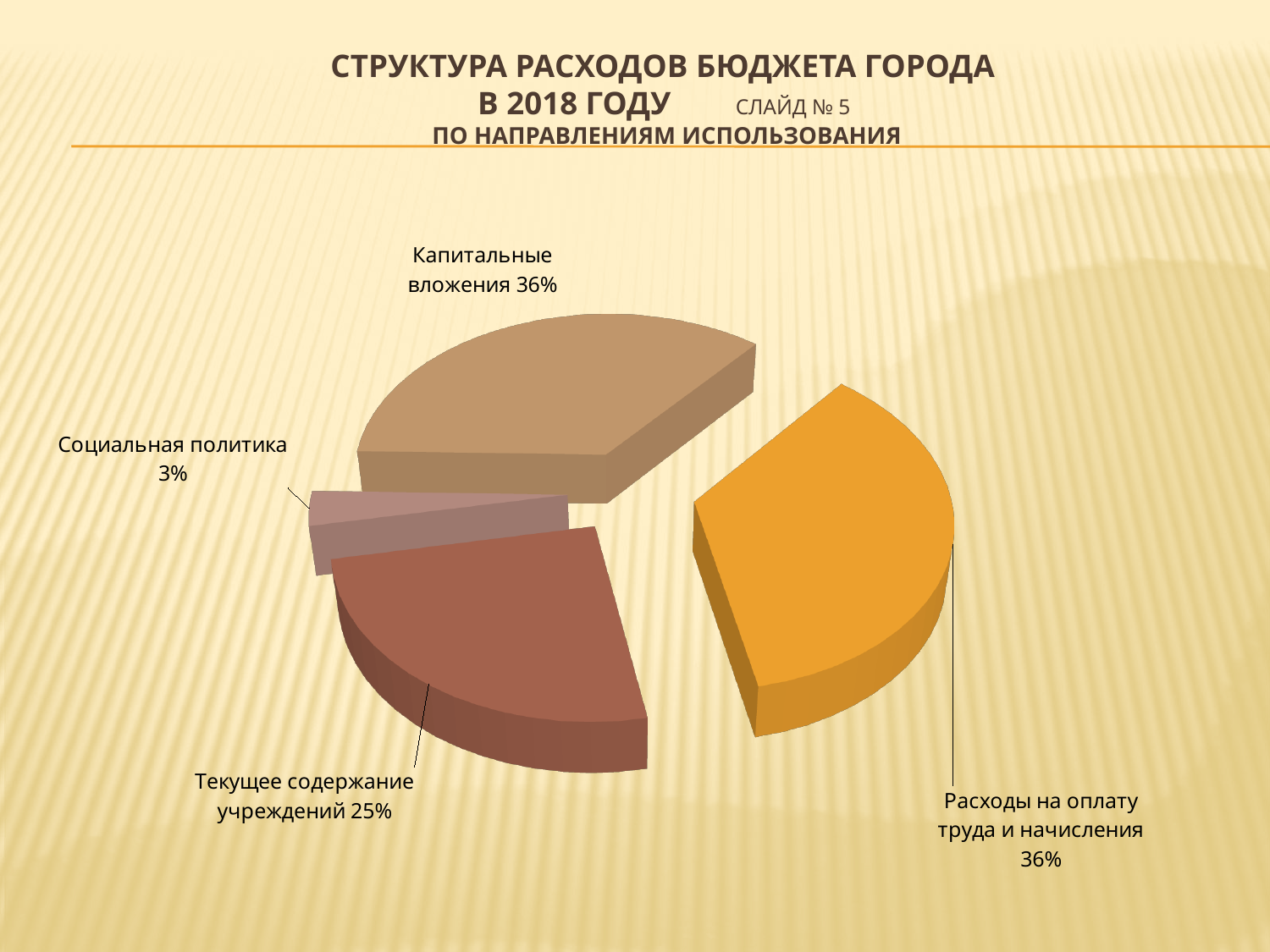
Which category has the smallest share of the pie? Социальная политика How many slices does the pie chart have? 4 What share of the budget expenditure is Текущее содержание учреждений? 25% Which is larger: Капитальные вложения or Текущее содержание учреждений? Капитальные вложения What share of the budget expenditure is Капитальные вложения? 36% Which is larger: Текущее содержание учреждений or Социальная политика? Текущее содержание учреждений What share of the budget expenditure is Расходы на оплату труда и начисления? 36% By how many percentage points does Капитальные вложения exceed Текущее содержание учреждений? 11 By how many percentage points does Текущее содержание учреждений exceed Социальная политика? 22 Which year does the chart title say the budget expenditure structure refers to? 2018 What share of the budget expenditure is Социальная политика? 3% What kind of chart is shown on the slide? Pie chart